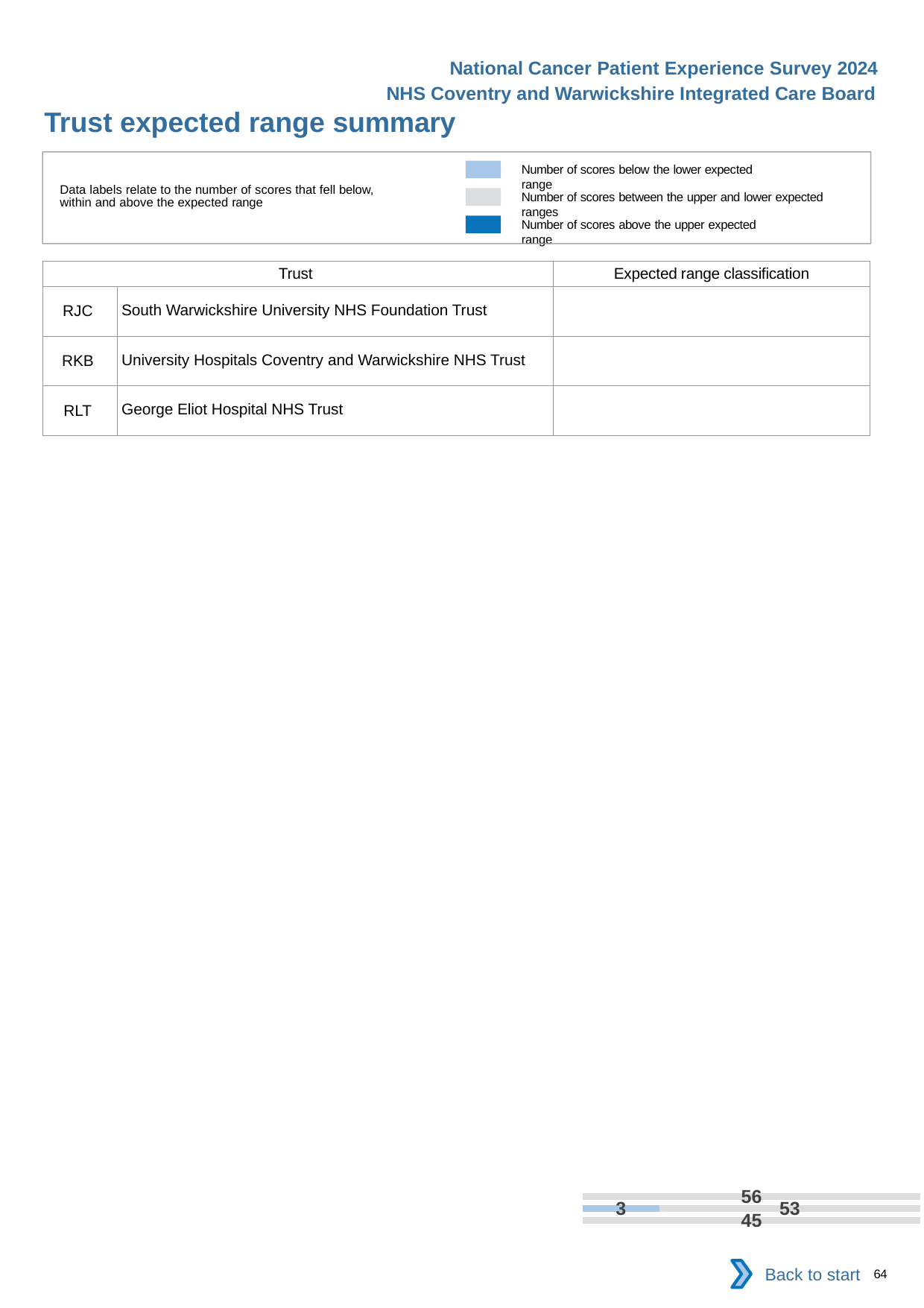
In the chart at the bottom right of the slide, what value is printed on the bottom bar? 45 In the chart at the bottom right of the slide, what value is printed on the grey segment of the middle bar? 53 In the chart at the bottom right of the slide, what value is printed on the light blue segment of the middle bar? 3 According to the legend, which colour represents the number of scores below the lower expected range? light blue How many entries does the legend at the top of the slide list? 3 In the chart at the bottom right of the slide, what value is printed on the top bar? 56 What kind of chart is shown at the bottom right of the slide? bar chart In the chart at the bottom right of the slide, what is the total of the middle stacked bar (3 and 53)? 56 In the chart at the bottom right of the slide, which is larger: the grey segment of the middle bar (53) or the bottom bar (45)? 53 How many horizontal bars are shown in the chart at the bottom right of the slide? 3 In the chart at the bottom right of the slide, what is the difference between the top bar value (56) and the bottom bar value (45)? 11 According to the legend, which colour represents the number of scores above the upper expected range? dark blue